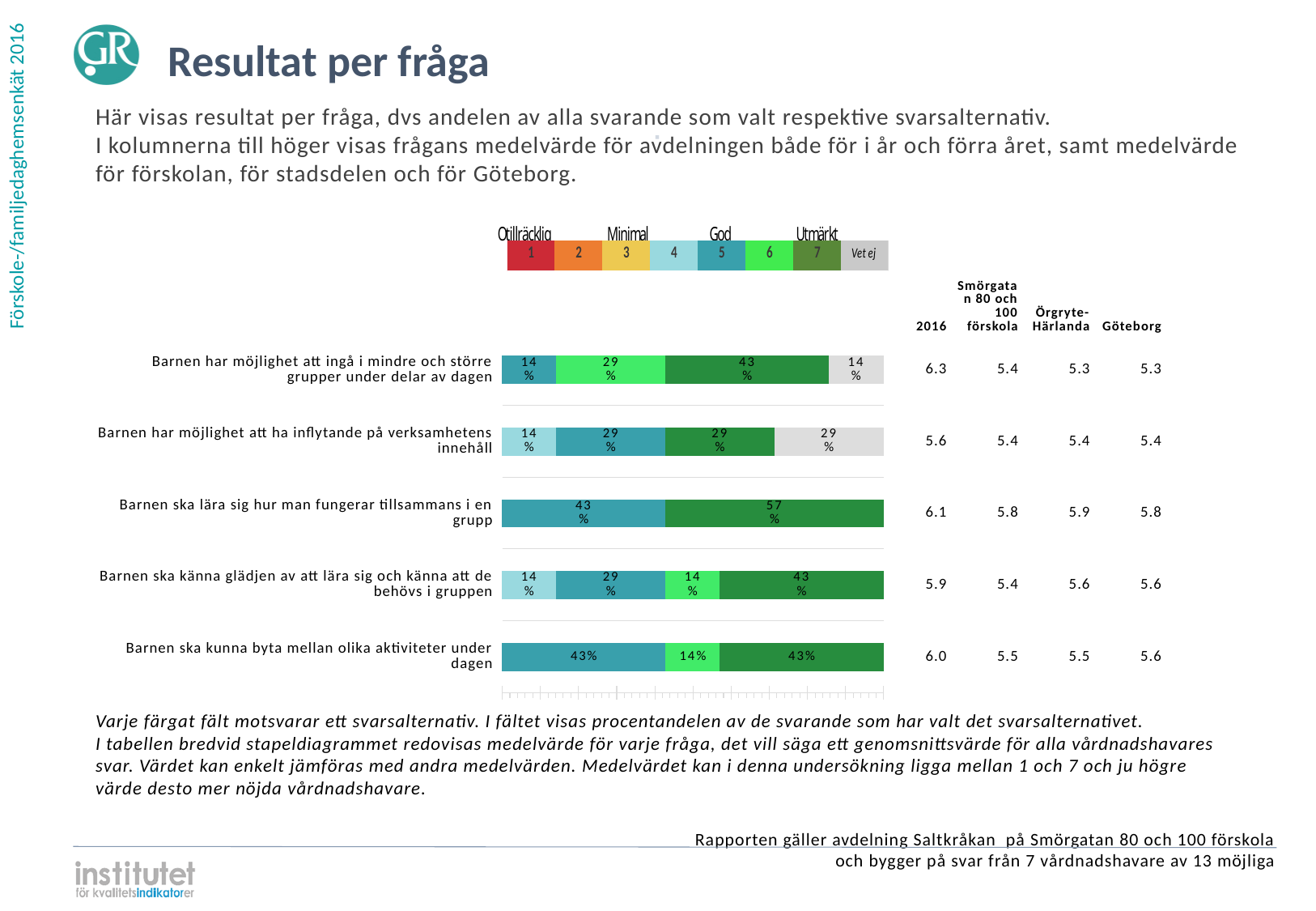
How many questions (categories) are plotted as bars in the chart? 5 What is the total of the three segments in the bar for "Barnen ska kunna byta mellan olika aktiviteter under dagen"? 100% What percentage is shown in the light green segment of the bar for "Barnen ska kunna byta mellan olika aktiviteter under dagen"? 14% What percentage is shown in the grey (Vet ej) segment of the bar for "Barnen har möjlighet att ha inflytande på verksamhetens innehåll"? 29% What percentage is shown in the dark green segment of the bar for "Barnen ska lära sig hur man fungerar tillsammans i en grupp"? 57% In the bar for "Barnen ska lära sig hur man fungerar tillsammans i en grupp", what is the difference between the dark green segment and the teal segment? 14 percentage points What label is given to the grey box at the right end of the colour legend? Vet ej In the bar for "Barnen har möjlighet att ingå i mindre och större grupper under delar av dagen", which is larger: the dark green segment or the light green segment? The dark green segment (43%) Which bar contains the largest single segment in the chart? Barnen ska lära sig hur man fungerar tillsammans i en grupp How many segments make up the bar for "Barnen ska känna glädjen av att lära sig och känna att de behövs i gruppen"? 4 What four scale labels appear above the colour legend of the chart? Otillräcklig, Minimal, God, Utmärkt What kind of chart is shown on the slide? Stacked bar chart